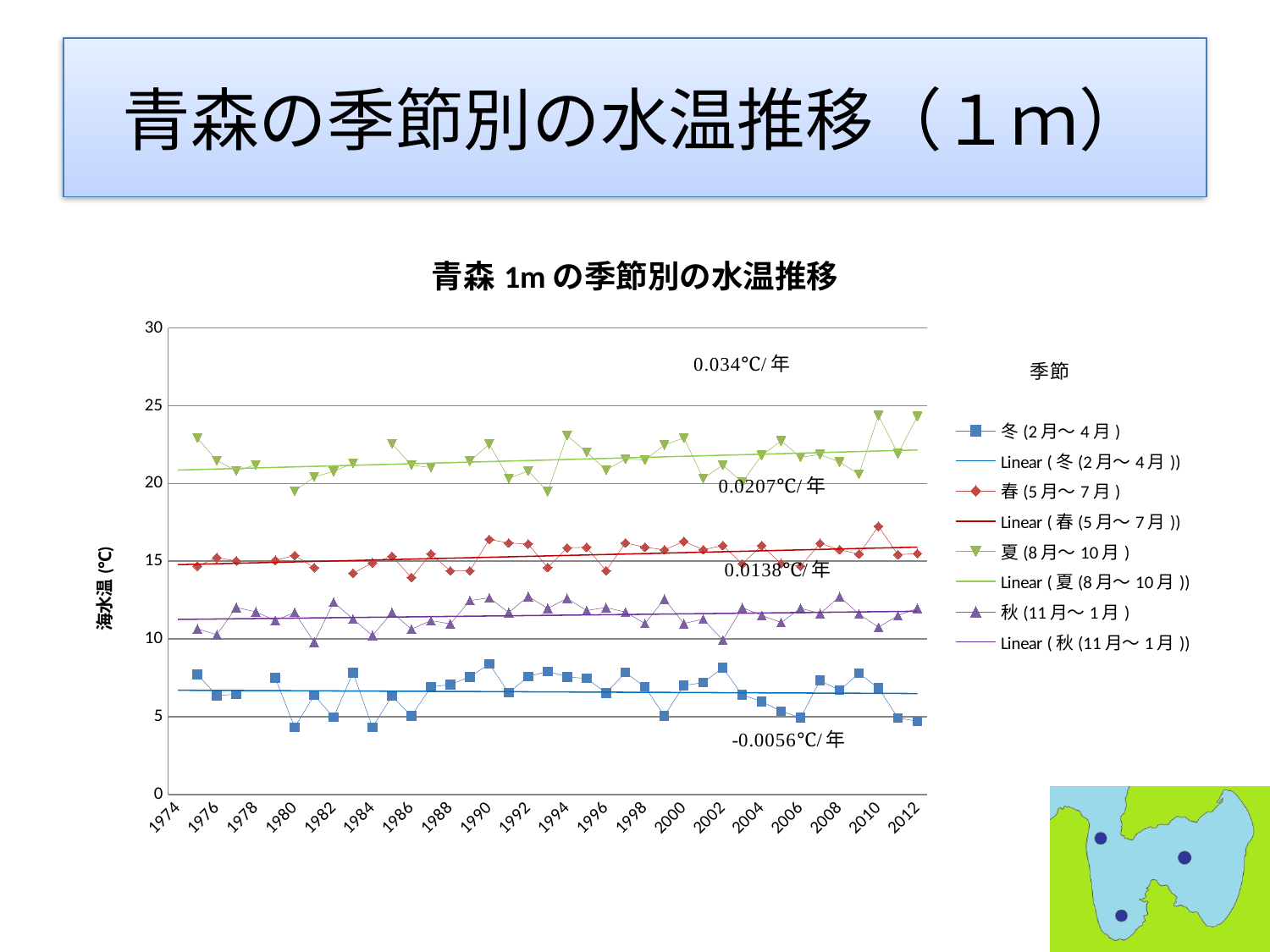
In 2010, which is larger, the value for 春 (5月～7月) or the value for 秋 (11月～1月)? 春 (5月～7月) What is the label of the vertical axis of the chart? 海水温 (℃) Is the value for 夏 (8月～10月) in 2010 greater or less than 20? greater What is the title of the chart? 青森 1m の季節別の水温推移 What kind of chart is shown on the slide? line chart What annual rate of change is printed next to the winter (冬) trend line? -0.0056℃/年 What annual rate of change is printed next to the spring (春) trend line? 0.0207℃/年 Does the winter (冬) trend line rise or fall from 1974 to 2012? fall Which season's series has the highest water temperatures in the chart? 夏 (8月～10月) Which season's series has the lowest water temperatures in the chart? 冬 (2月～4月) What annual rate of change is printed next to the summer (夏) trend line? 0.034℃/年 How many entries does the legend of the chart list? 8